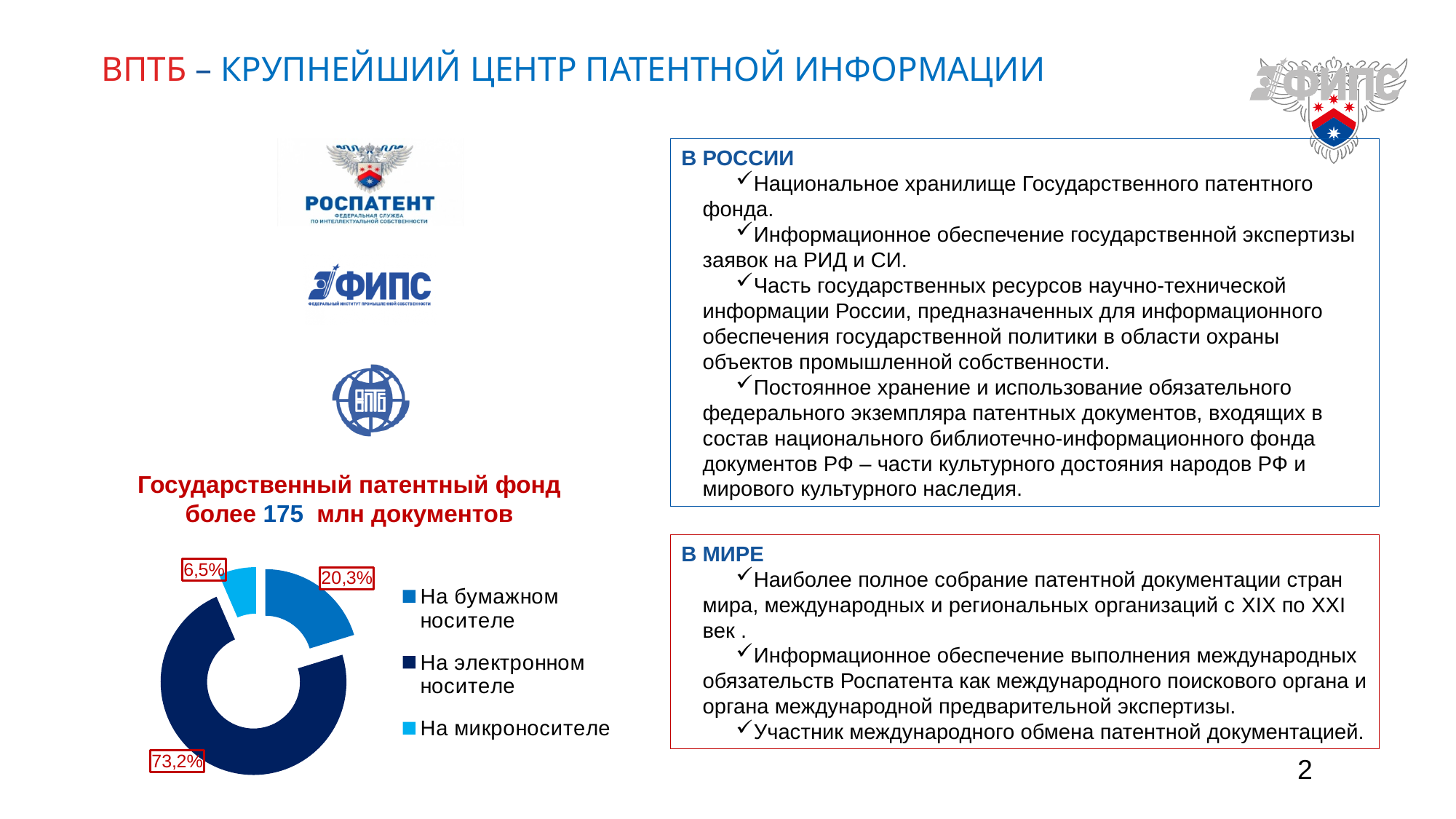
What share of the fund is on paper media (На бумажном носителе)? 20,3% Which is larger: the share on paper media or the share on micro media? На бумажном носителе What share of the fund is on electronic media (На электронном носителе)? 73,2% How many entries does the chart legend list? 3 Which category has the smallest share in the chart? На микроносителе What is the difference in percentage points between the electronic media share and the paper media share? 52,9 How many categories does the chart show? 3 What type of chart is shown on the slide? doughnut chart What is the difference in percentage points between the paper media share and the micro media share? 13,8 Which category has the largest share in the chart? На электронном носителе According to the heading above the chart, how many documents does the State Patent Fund contain? более 175 млн документов What share of the fund is on micro media (На микроносителе)? 6,5%